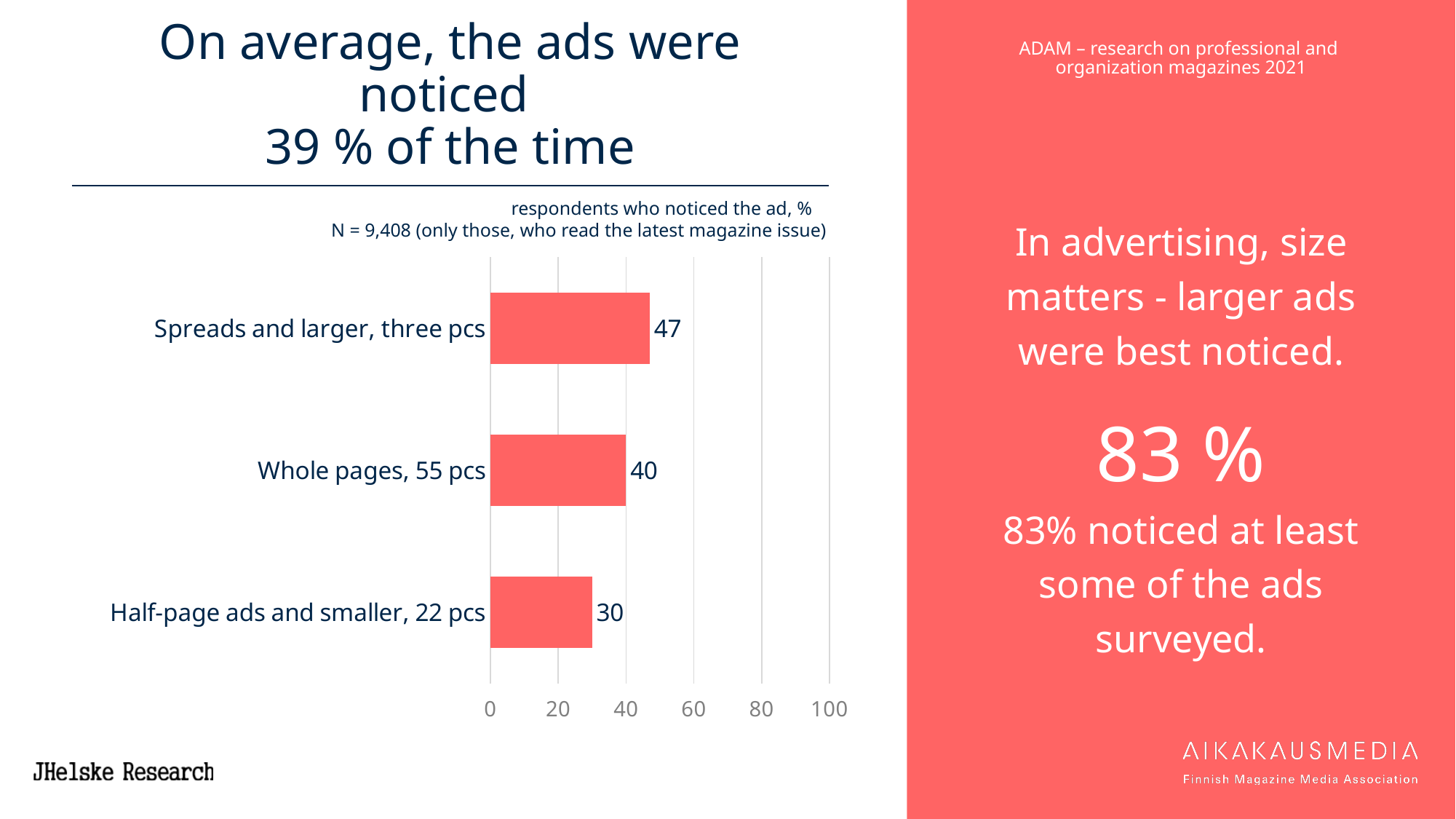
What percentage of respondents noticed the ad for 'Spreads and larger, three pcs'? 47 Which ad size category has the highest share of respondents who noticed the ad? Spreads and larger, three pcs What is the maximum value shown on the chart's horizontal axis? 100 Is the value for 'Spreads and larger, three pcs' greater or less than 40? greater What kind of chart is shown on the slide? Bar chart What is the difference between the values for 'Spreads and larger, three pcs' and 'Half-page ads and smaller, 22 pcs'? 17 What is the value shown for 'Half-page ads and smaller, 22 pcs'? 30 What is the difference between the values for 'Whole pages, 55 pcs' and 'Half-page ads and smaller, 22 pcs'? 10 Which has a larger value: 'Whole pages, 55 pcs' or 'Half-page ads and smaller, 22 pcs'? Whole pages, 55 pcs Which ad size category has the lowest share of respondents who noticed the ad? Half-page ads and smaller, 22 pcs How many categories are shown in the chart? 3 What is the value shown for 'Whole pages, 55 pcs'? 40